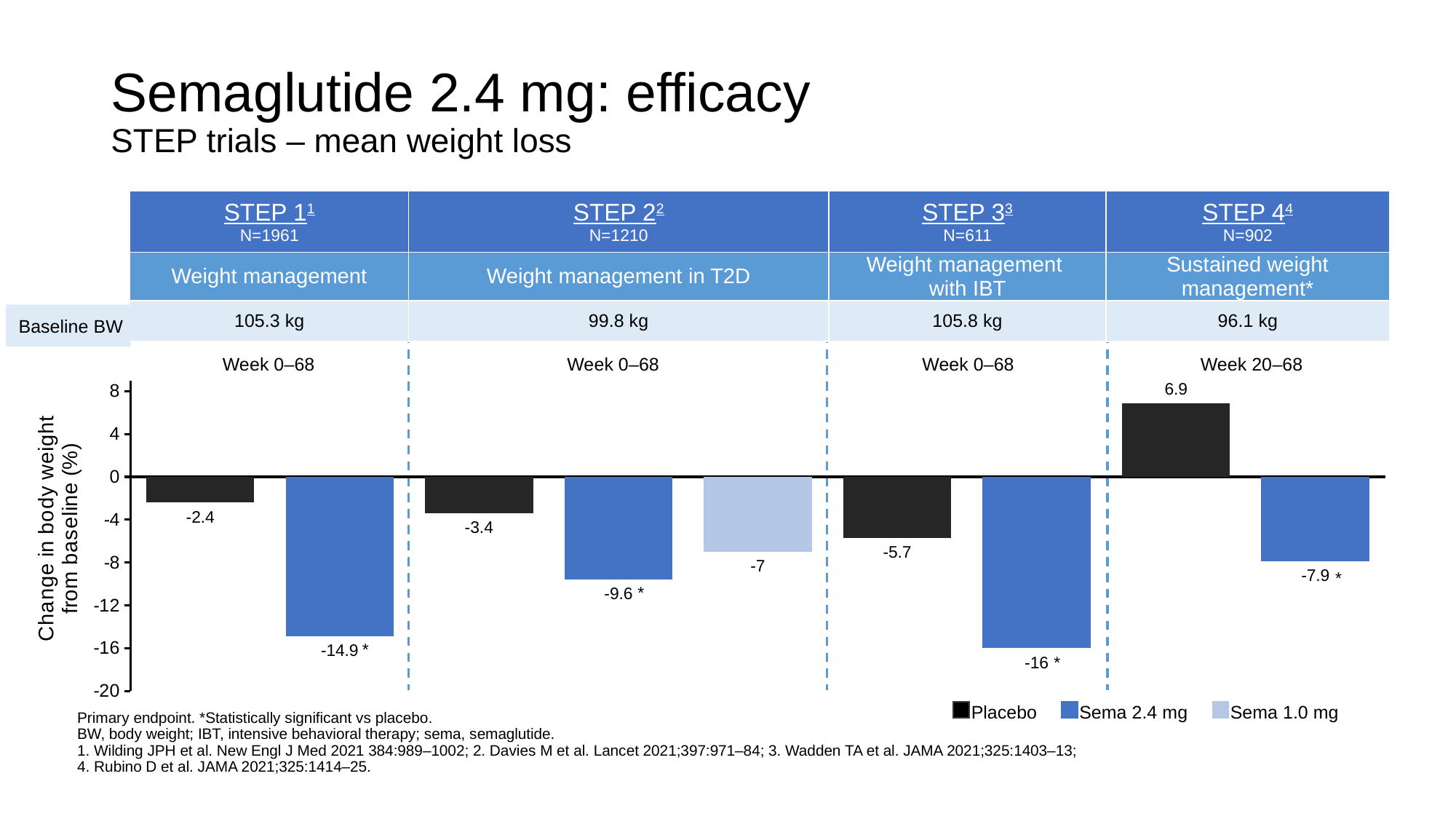
How many series does the legend list? 3 What kind of chart is shown on the slide? Bar chart In which STEP trial does Sema 2.4 mg show the largest weight loss? STEP 3 Which trial has the smallest weight loss for Sema 2.4 mg? STEP 4 What is the change in body weight for Placebo in STEP 4? 6.9 What is the label of the vertical axis? Change in body weight from baseline (%) What is the change in body weight for Sema 1.0 mg in STEP 2? -7 What is the change in body weight for Sema 2.4 mg in STEP 1? -14.9 How many STEP trials are shown in the chart? 4 What is the difference between the Sema 2.4 mg and Placebo values in STEP 3? 10.3 What is the change in body weight for Placebo in STEP 2? -3.4 In STEP 2, which shows a larger weight loss: Sema 2.4 mg or Sema 1.0 mg? Sema 2.4 mg